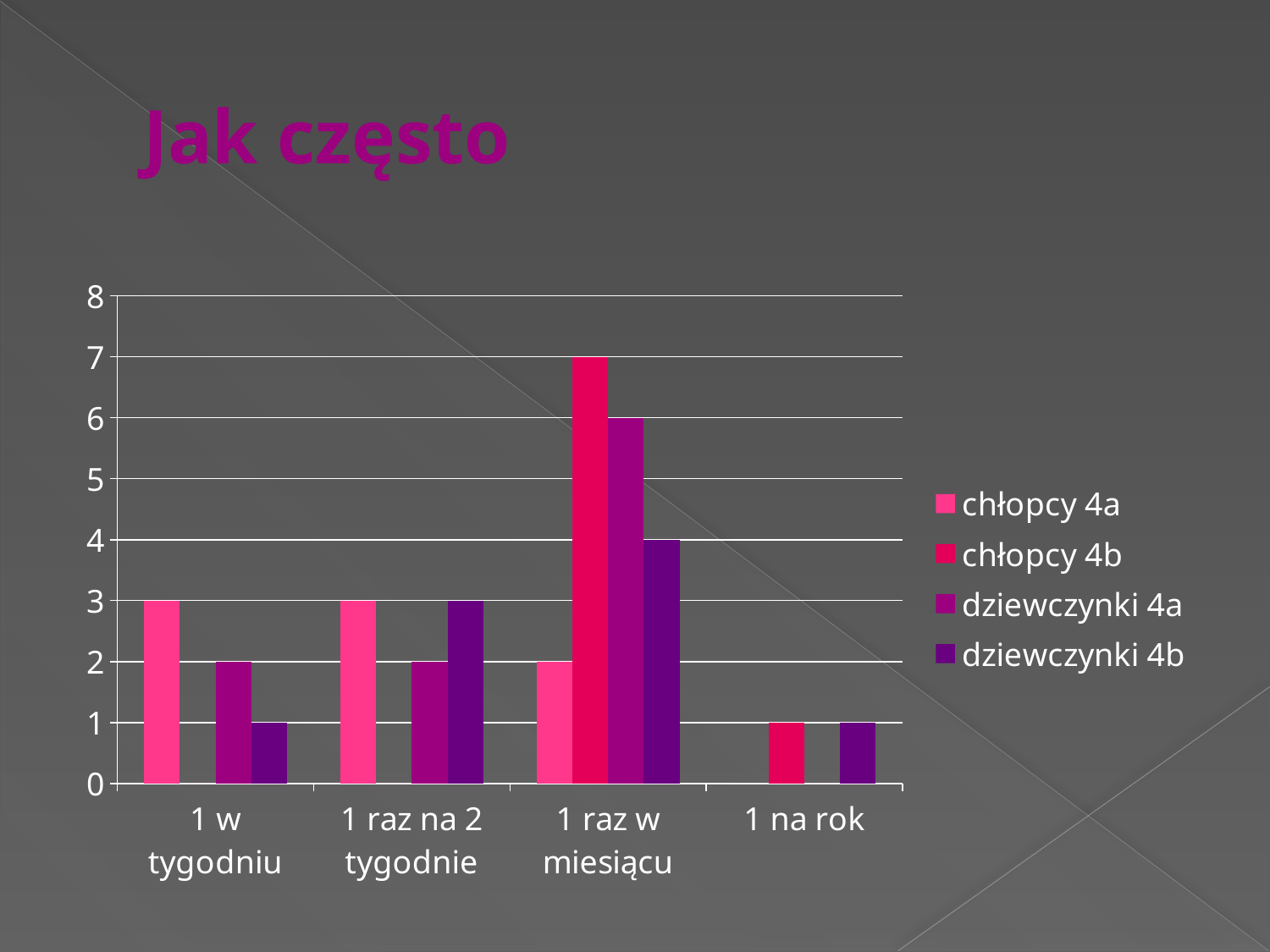
What is the difference between chłopcy 4b and dziewczynki 4b in the category '1 raz w miesiącu'? 3 What is the title of the chart? Jak często How many categories are shown on the x axis? 4 In the category '1 w tygodniu', which is larger: chłopcy 4a or dziewczynki 4b? chłopcy 4a Which category has the highest value for dziewczynki 4a? 1 raz w miesiącu Is the value for chłopcy 4b in '1 raz w miesiącu' greater or less than 5? greater How many series does the legend list? 4 What is the value for dziewczynki 4b in the category '1 raz na 2 tygodnie'? 3 What is the value for chłopcy 4b in the category '1 raz w miesiącu'? 7 What is the value for dziewczynki 4a in the category '1 w tygodniu'? 2 What kind of chart is shown on the slide? bar chart